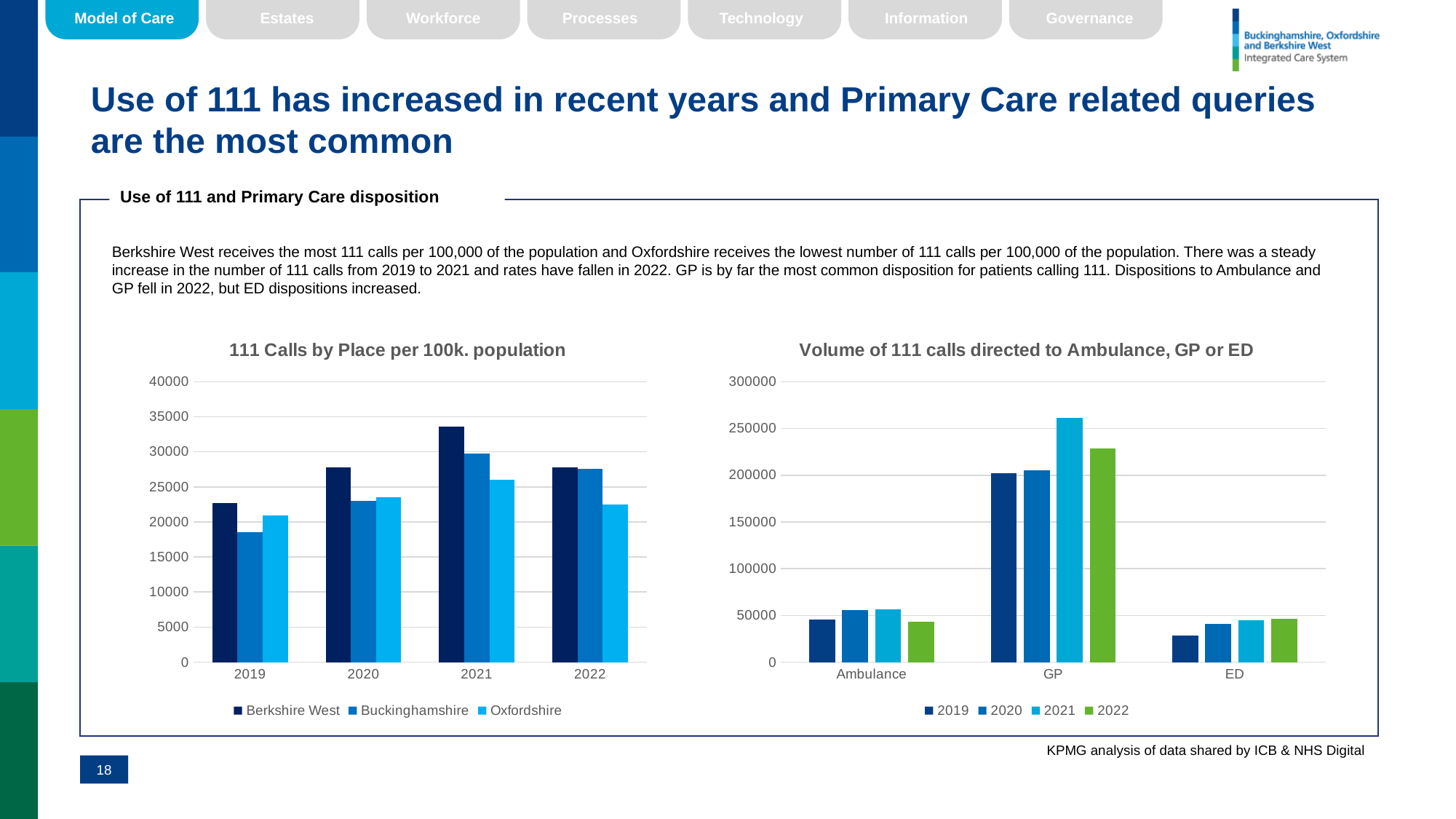
What kind of chart is the '111 Calls by Place per 100k. population' chart? bar chart In the 'Volume of 111 calls directed to Ambulance, GP or ED' chart, is the GP value for 2021 greater or less than 250000? greater How many years are shown on the x axis of the '111 Calls by Place per 100k. population' chart? 4 In the '111 Calls by Place per 100k. population' chart, is the Berkshire West value for 2021 greater or less than 30000? greater In the 'Volume of 111 calls directed to Ambulance, GP or ED' chart, which category has the highest value for 2021? GP In the '111 Calls by Place per 100k. population' chart, is the Buckinghamshire value for 2019 greater or less than 20000? less In the '111 Calls by Place per 100k. population' chart, which is larger in 2021: Berkshire West or Oxfordshire? Berkshire West How many series does the legend of the '111 Calls by Place per 100k. population' chart list? 3 How many series does the legend of the 'Volume of 111 calls directed to Ambulance, GP or ED' chart list? 4 In the 'Volume of 111 calls directed to Ambulance, GP or ED' chart, do the ED values rise or fall from 2019 to 2022? rise In the '111 Calls by Place per 100k. population' chart, in which year is the Berkshire West value highest? 2021